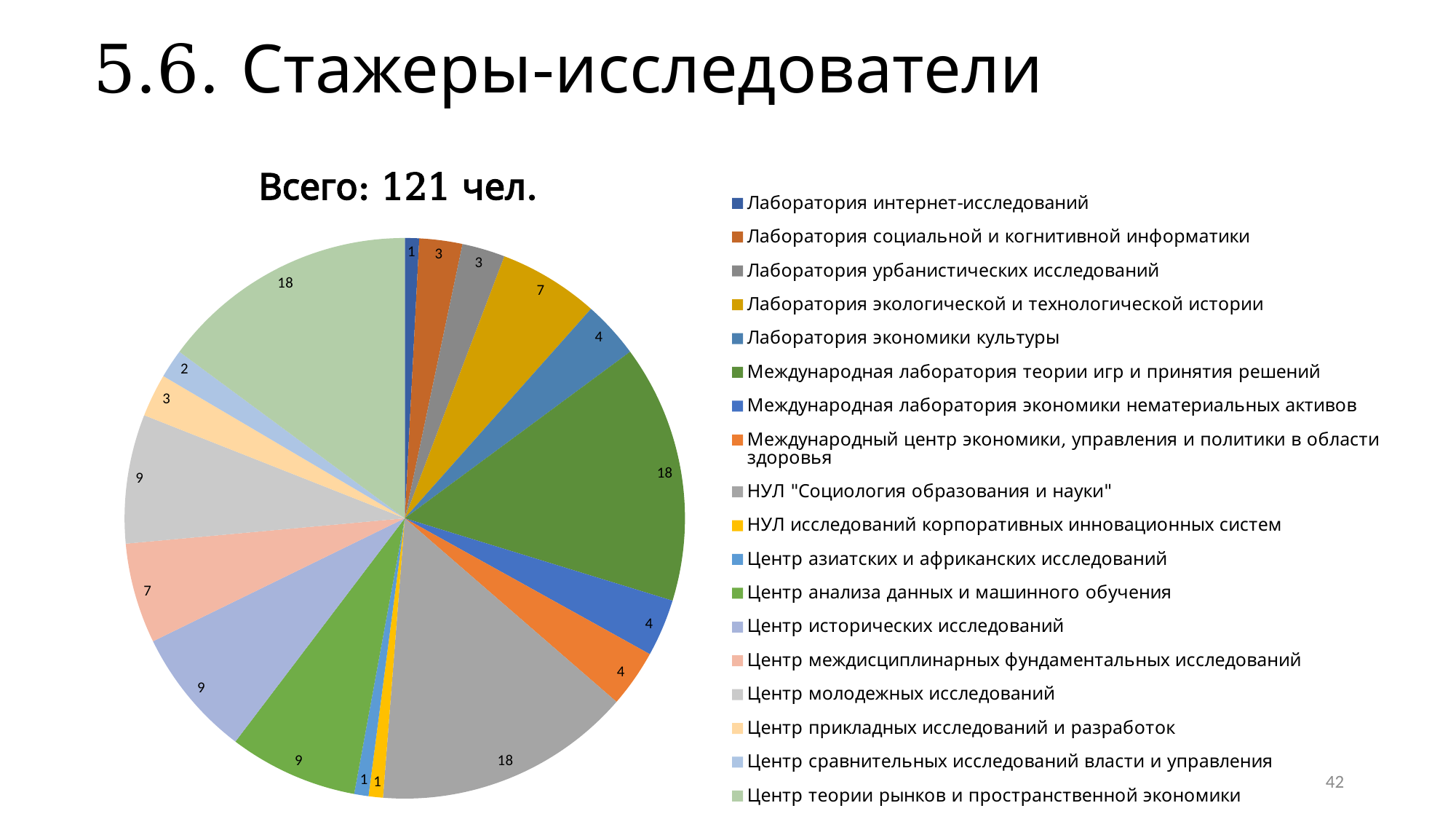
What is the value for Центр прикладных исследований и разработок? 3 How many categories does the legend list? 18 What is the difference between the values for Лаборатория экологической и технологической истории and Лаборатория социальной и когнитивной информатики? 4 What is the value for Центр сравнительных исследований власти и управления? 2 Which is larger: the value for Лаборатория экономики культуры or the value for Центр междисциплинарных фундаментальных исследований? Центр междисциплинарных фундаментальных исследований What is the value for Лаборатория экологической и технологической истории? 7 What is the total number of people shown in the chart title? 121 чел. What is the value for Центр анализа данных и машинного обучения? 9 What kind of chart is shown on the slide? pie chart What is the value for Международная лаборатория теории игр и принятия решений? 18 What is the value for Лаборатория интернет-исследований? 1 What is the difference between the values for Центр теории рынков и пространственной экономики and Центр молодежных исследований? 9